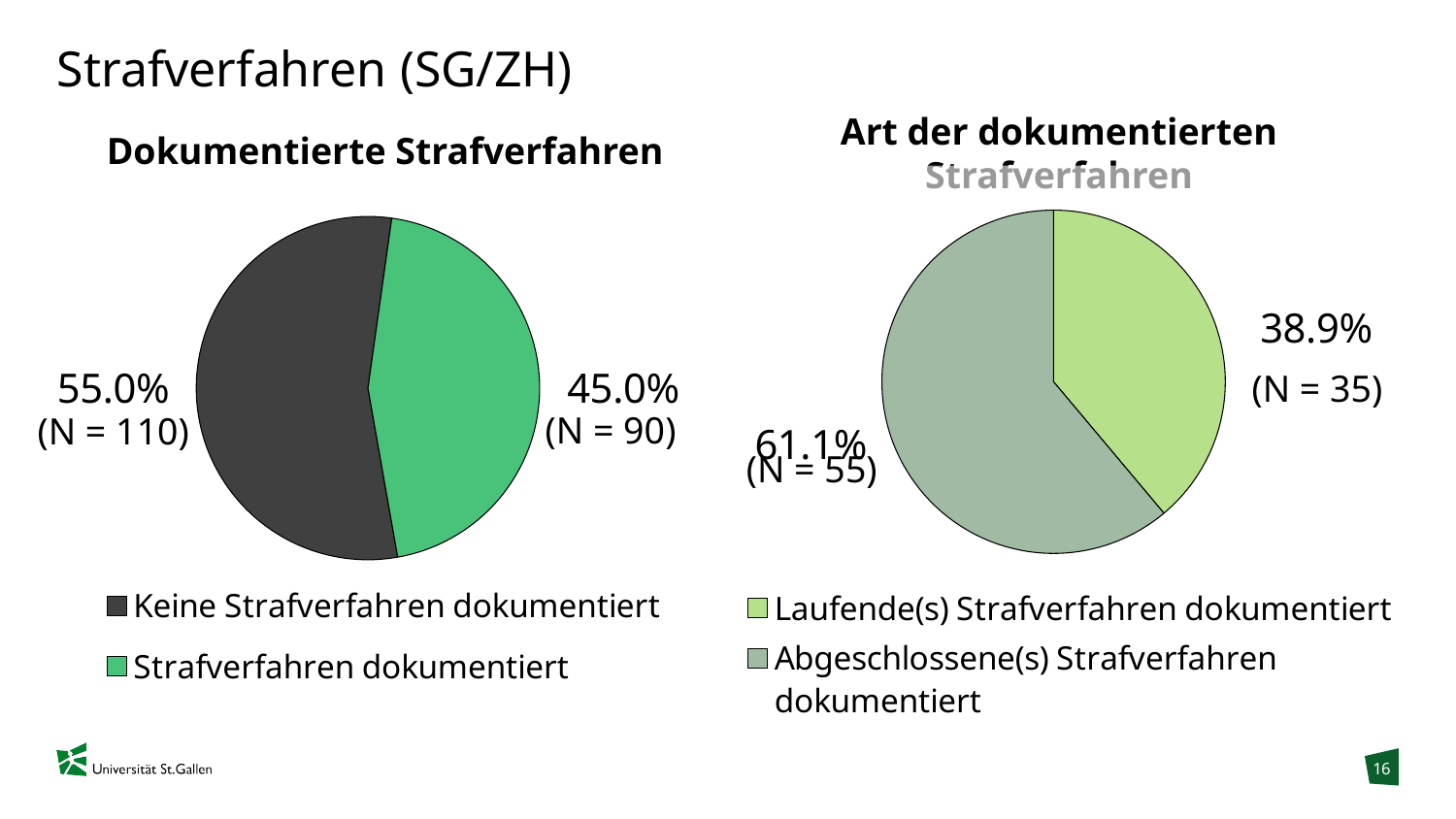
In the 'Dokumentierte Strafverfahren' chart, what is the N value for 'Keine Strafverfahren dokumentiert'? N = 110 In the 'Dokumentierte Strafverfahren' chart, what is the difference in percentage points between 'Keine Strafverfahren dokumentiert' and 'Strafverfahren dokumentiert'? 10.0 percentage points In the 'Dokumentierte Strafverfahren' chart, which category has the larger share? Keine Strafverfahren dokumentiert In the 'Dokumentierte Strafverfahren' chart, what percentage is shown for 'Strafverfahren dokumentiert'? 45.0% How many slices does the 'Art der dokumentierten Strafverfahren' pie chart have? 2 In the 'Art der dokumentierten Strafverfahren' chart, how many more cases (N) are 'Abgeschlossene(s)' than 'Laufende(s)'? 20 In the 'Art der dokumentierten Strafverfahren' chart, is the share for 'Abgeschlossene(s) Strafverfahren dokumentiert' larger or smaller than that for 'Laufende(s) Strafverfahren dokumentiert'? larger In the 'Art der dokumentierten Strafverfahren' chart, which category has the smaller share? Laufende(s) Strafverfahren dokumentiert What colour is the 'Keine Strafverfahren dokumentiert' slice in the 'Dokumentierte Strafverfahren' chart? dark grey What type of chart is used on the left side of the slide? pie chart In the 'Art der dokumentierten Strafverfahren' chart, what is the N value for 'Abgeschlossene(s) Strafverfahren dokumentiert'? N = 55 In the 'Art der dokumentierten Strafverfahren' chart, what percentage is shown for 'Laufende(s) Strafverfahren dokumentiert'? 38.9%